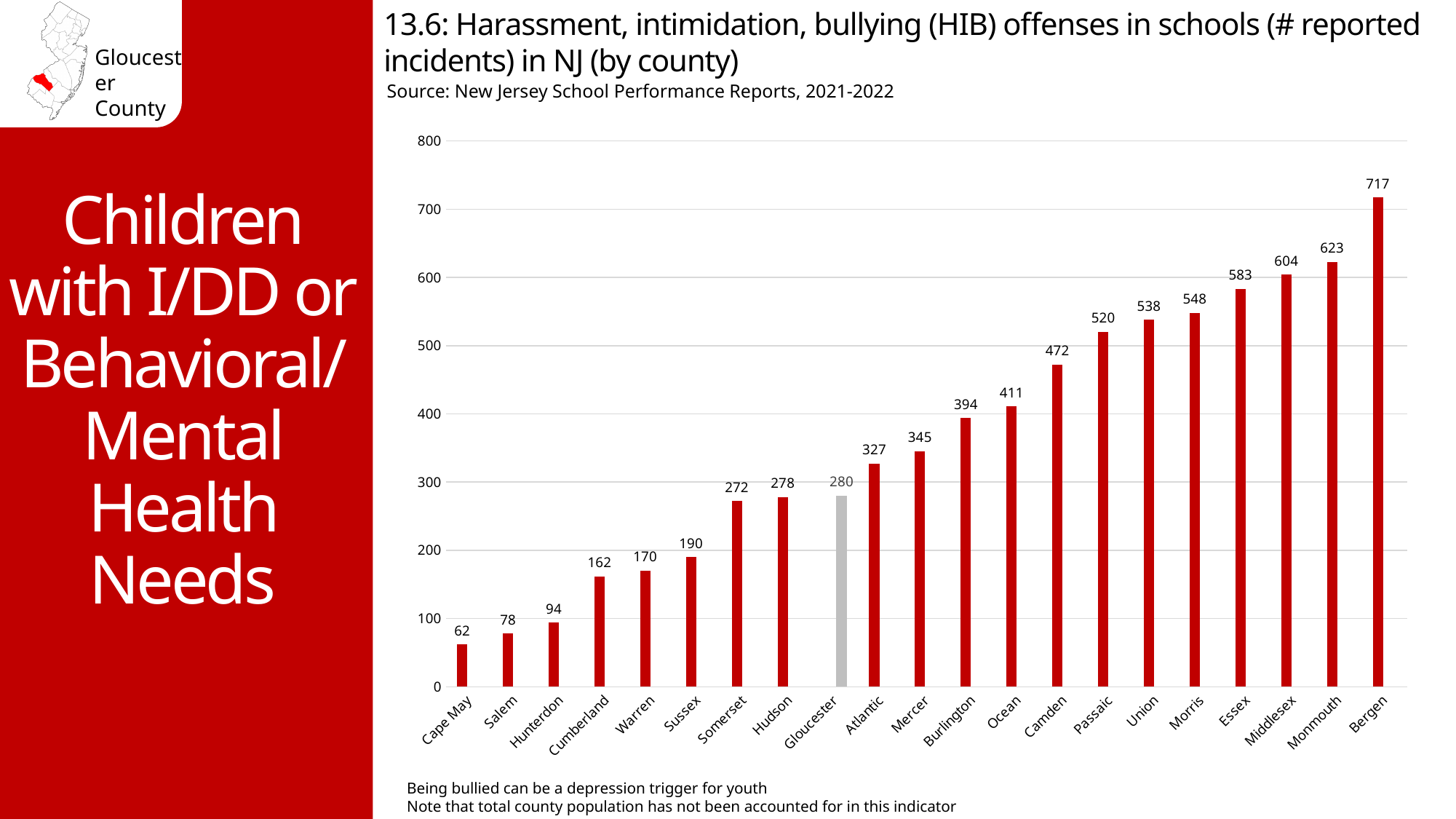
What type of chart is shown on the slide? bar chart Which county's bar is shown in grey rather than red? Gloucester Which has a higher value, Passaic or Ocean? Passaic Is the value for Essex greater or less than 600? less What is the value shown for Cape May? 62 What is the difference between the values for Bergen and Monmouth? 94 Which county has the highest number of reported HIB incidents? Bergen How many counties are shown on the chart? 21 What is the value shown for Camden? 472 Which county has the lowest number of reported HIB incidents? Cape May How many reported HIB incidents does the chart show for Gloucester County? 280 What is the difference between the values for Gloucester and Hudson? 2